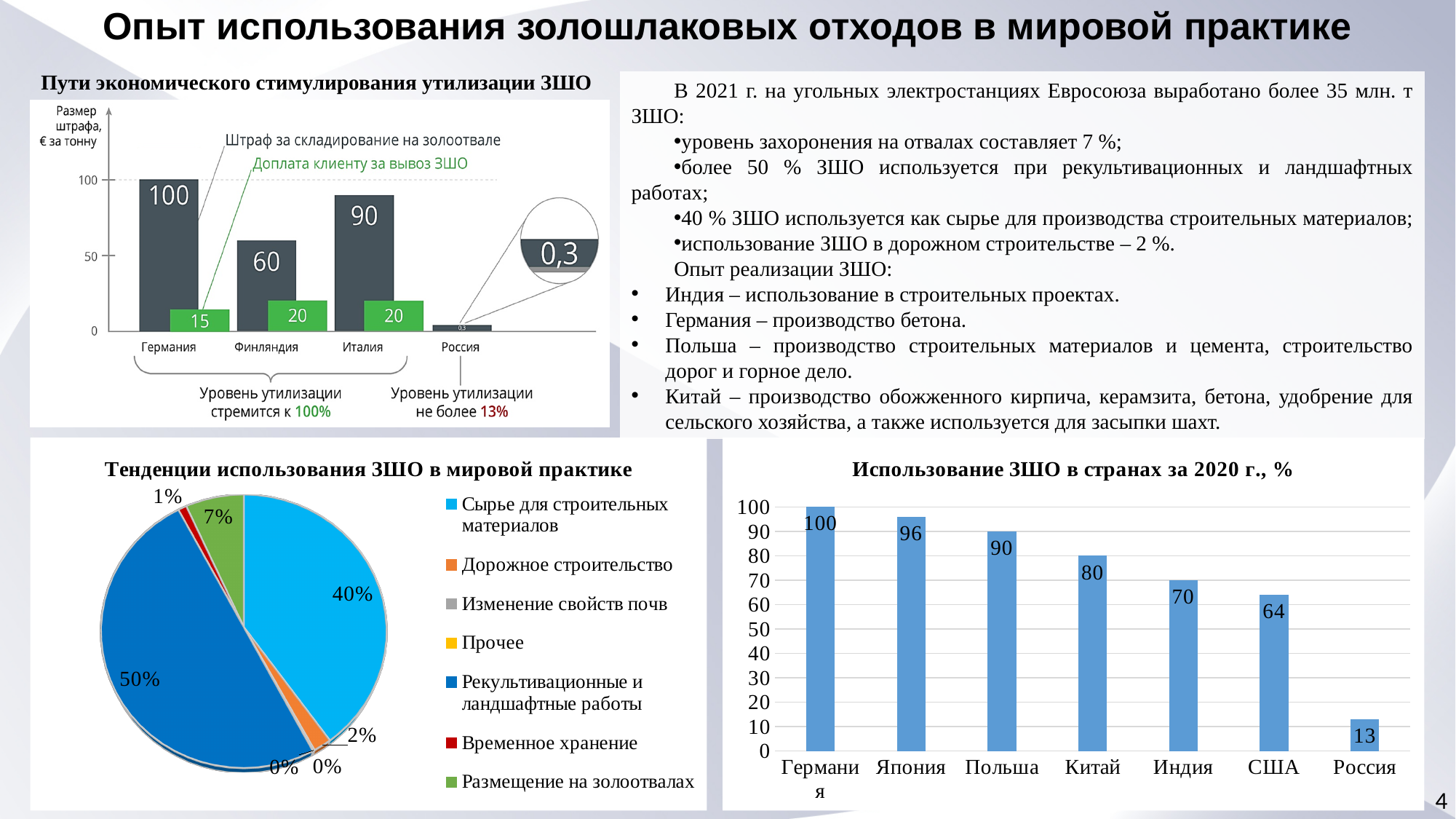
In the chart 'Использование ЗШО в странах за 2020 г., %', what is the value for Япония? 96 In the chart 'Пути экономического стимулирования утилизации ЗШО', what is the 'Доплата клиенту за вывоз ЗШО' for Германия? 15 In the chart 'Использование ЗШО в странах за 2020 г., %', do the values rise or fall from left to right? fall In the pie chart 'Тенденции использования ЗШО в мировой практике', what share is 'Размещение на золоотвалах'? 7% In the pie chart 'Тенденции использования ЗШО в мировой практике', what share is 'Рекультивационные и ландшафтные работы'? 50% In the chart 'Использование ЗШО в странах за 2020 г., %', which country has the lowest value? Россия How many entries does the legend of the pie chart 'Тенденции использования ЗШО в мировой практике' list? 7 In the chart 'Пути экономического стимулирования утилизации ЗШО', which is larger: the 'Штраф за складирование на золоотвале' for Италия or for Финляндия? Италия In the chart 'Использование ЗШО в странах за 2020 г., %', how many countries are shown? 7 In the chart 'Пути экономического стимулирования утилизации ЗШО', what is the 'Штраф за складирование на золоотвале' for Финляндия? 60 In the chart 'Использование ЗШО в странах за 2020 г., %', what is the difference between the values for Китай and США? 16 What kind of chart is 'Тенденции использования ЗШО в мировой практике'? pie chart